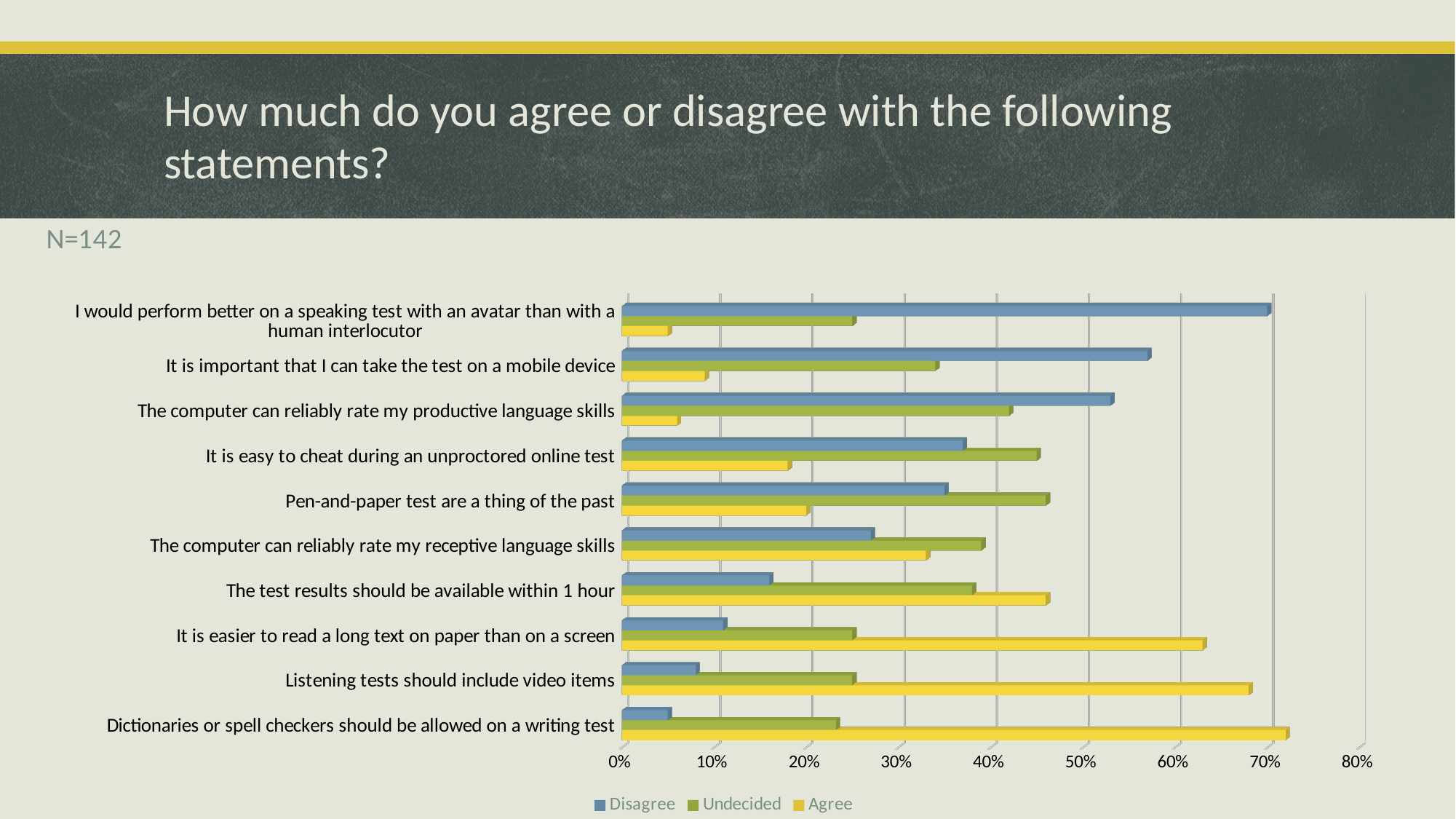
Which statement has the highest Disagree value? I would perform better on a speaking test with an avatar than with a human interlocutor Is the Undecided value for 'The computer can reliably rate my productive language skills' greater or less than 30%? greater Which is larger: the Agree value for 'It is easier to read a long text on paper than on a screen' or the Agree value for 'The test results should be available within 1 hour'? It is easier to read a long text on paper than on a screen What kind of chart is shown on the slide? Bar chart For 'It is easy to cheat during an unproctored online test', which is larger: the Disagree value or the Undecided value? Undecided How many statements (categories) are plotted on the chart? 10 Which statement has the highest Agree value? Dictionaries or spell checkers should be allowed on a writing test Is the Disagree value for 'I would perform better on a speaking test with an avatar than with a human interlocutor' greater or less than 60%? greater What sample size (N) is stated on the slide? N=142 How many series does the legend list? 3 Is the Agree value for 'Listening tests should include video items' greater or less than 60%? greater